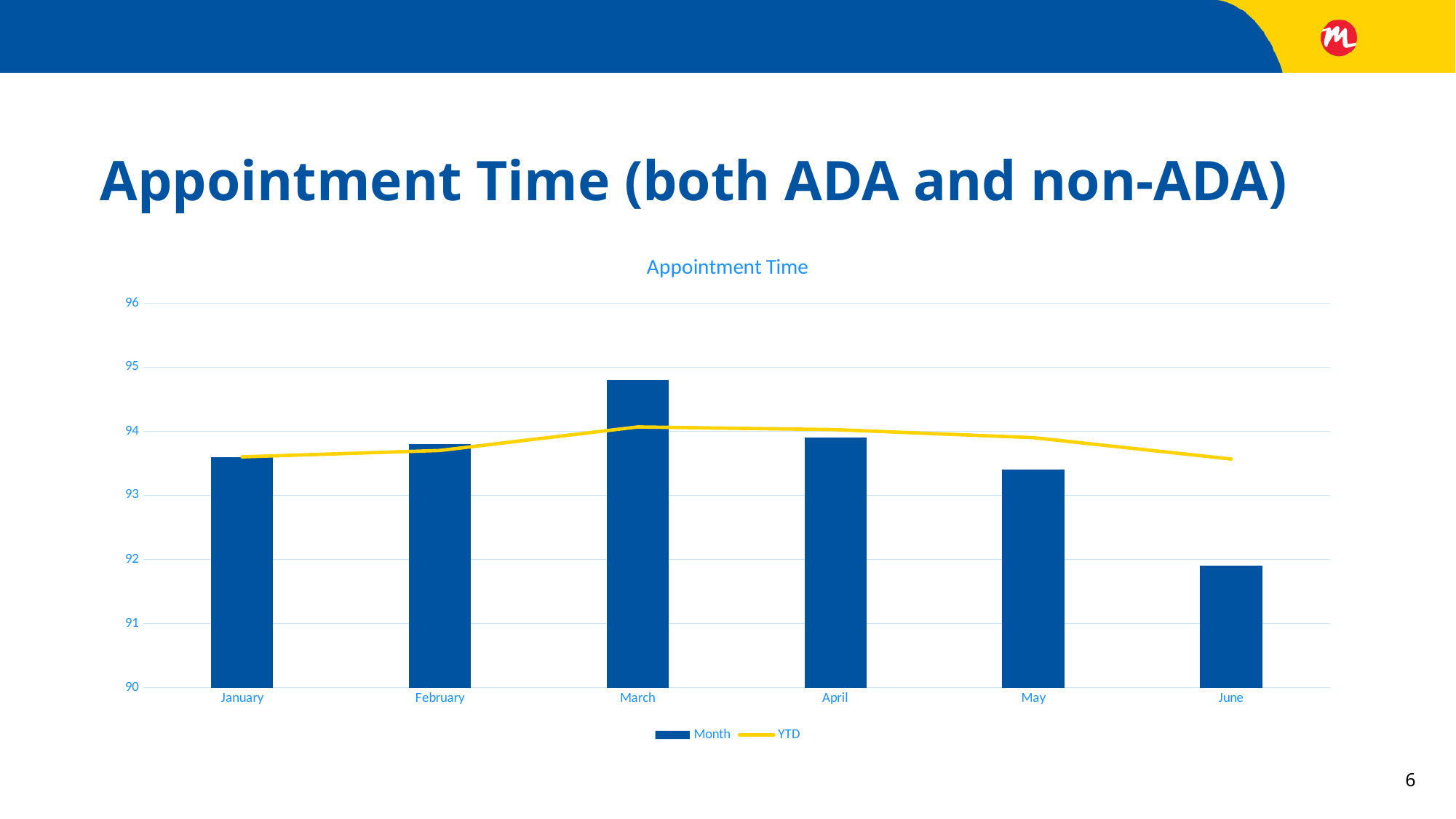
Is the Month value for May greater or less than 94? less Do the Month bars rise or fall from March to June? fall What are the two entries in the chart legend? Month and YTD Is the Month value for January greater or less than 93? greater Is the Month value for March greater or less than 94? greater How many series does the chart legend list? 2 Which has the larger Month value, May or June? May Which month has the lowest Month bar in the Appointment Time chart? June How many months are shown on the x axis of the chart? 6 Which has the larger Month value, March or June? March Which month has the highest Month bar in the Appointment Time chart? March